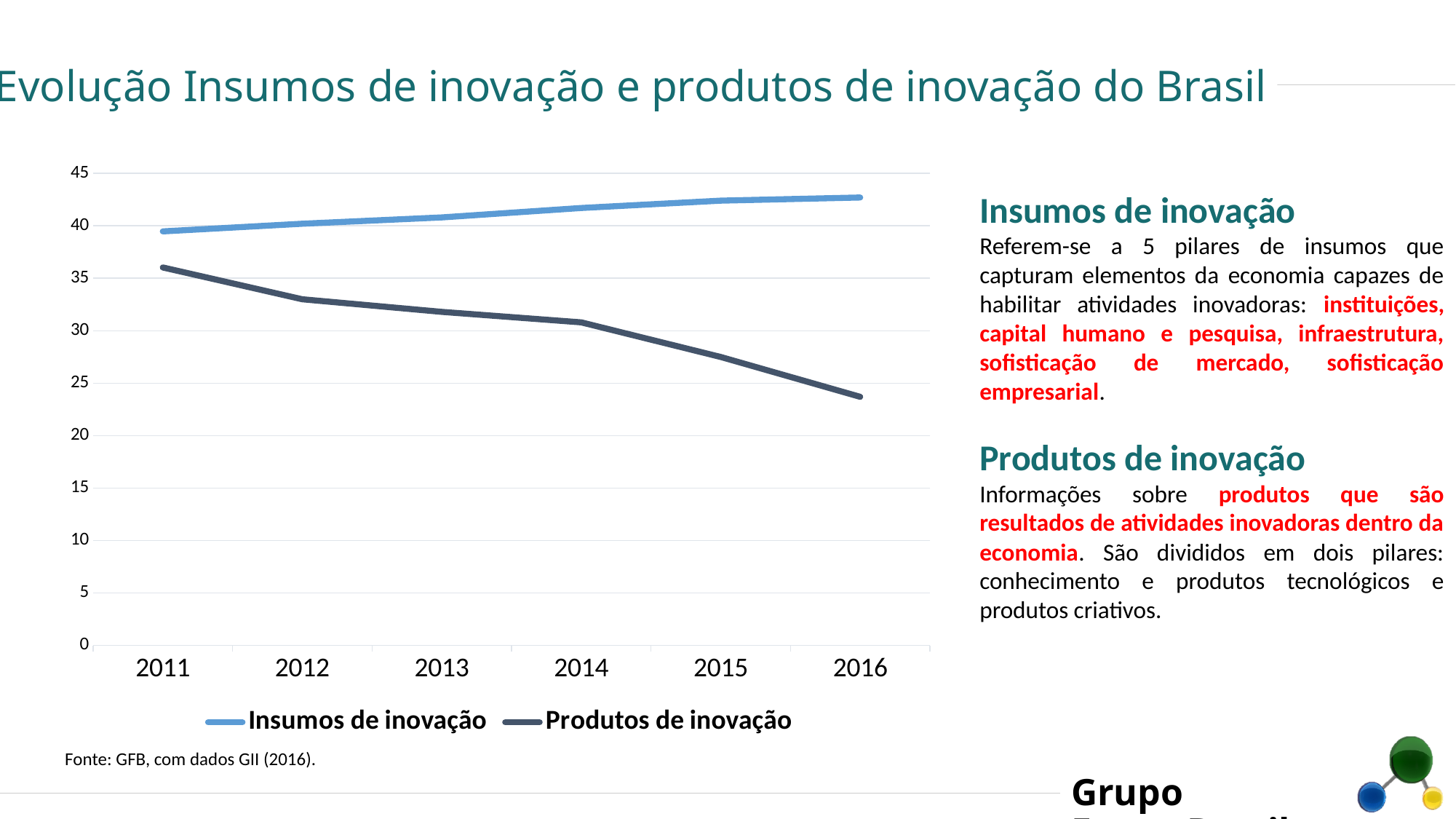
What kind of chart is shown on the slide? line chart Is the value for Produtos de inovação in 2016 greater or less than 25? less In 2016, which series has the larger value, Insumos de inovação or Produtos de inovação? Insumos de inovação Does the Insumos de inovação line rise or fall from 2011 to 2016? rises In which year is Produtos de inovação at its lowest? 2016 In which year is Insumos de inovação at its highest? 2016 Is the value for Insumos de inovação in 2016 greater or less than 40? greater What is the source cited below the chart? GFB, com dados GII (2016) Is the value for Produtos de inovação in 2015 greater or less than 30? less Does the Produtos de inovação line rise or fall from 2011 to 2016? falls How many series does the legend list? 2 How many years are shown on the x axis? 6